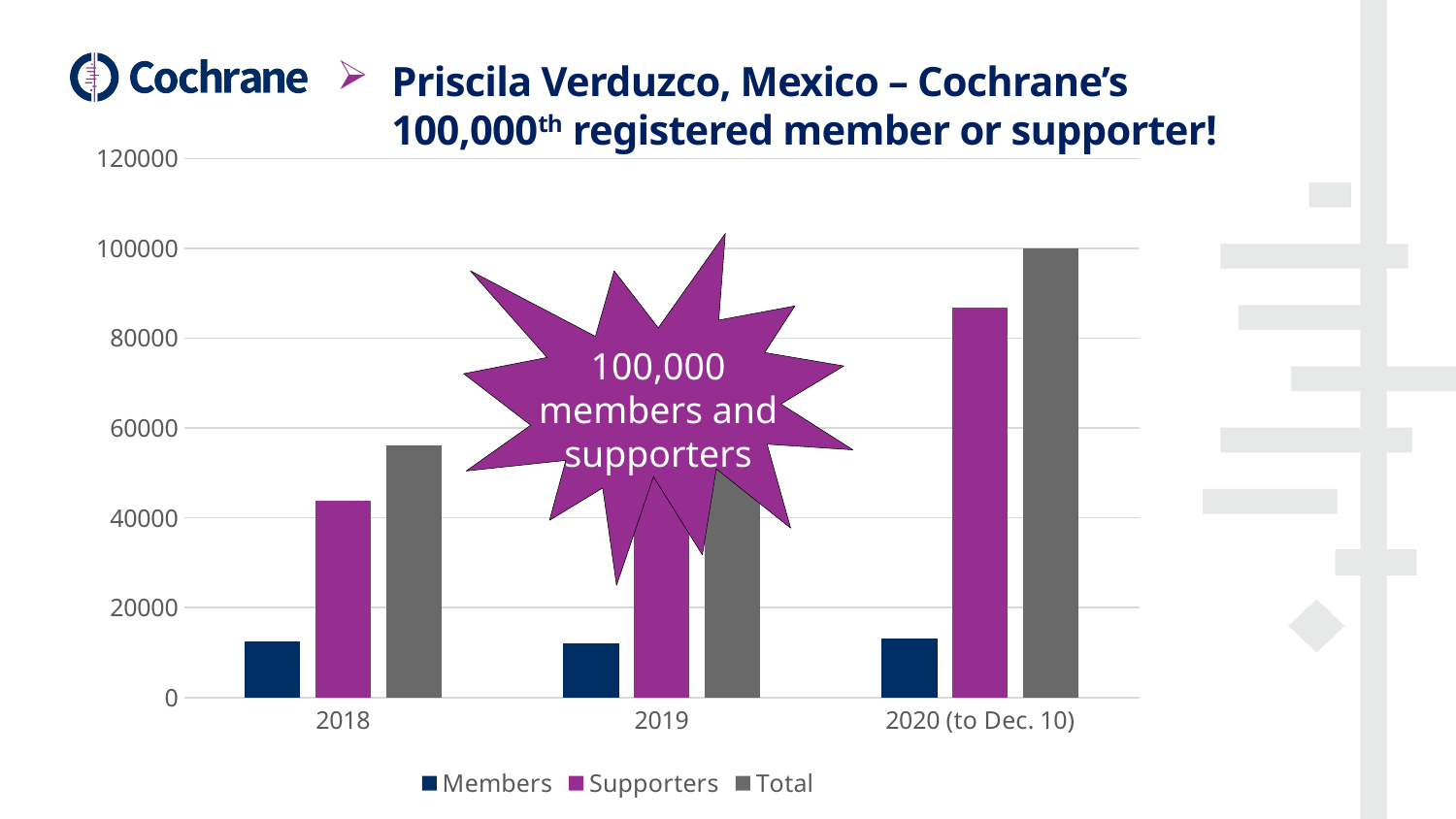
What kind of chart is shown on the slide? bar chart Is the value for Supporters in 2018 greater or less than 40000? greater How many categories are shown on the x axis? 3 How many series does the legend list? 3 Is the value for Total in 2018 greater or less than 60000? less Which series has the lowest value in 2020 (to Dec. 10)? Members Is the value for Members in 2018 greater or less than 20000? less Which is larger: Supporters in 2018 or Supporters in 2020 (to Dec. 10)? Supporters in 2020 (to Dec. 10) What are the three series named in the legend? Members, Supporters, Total Which bar is the highest in the chart? Total for 2020 (to Dec. 10)